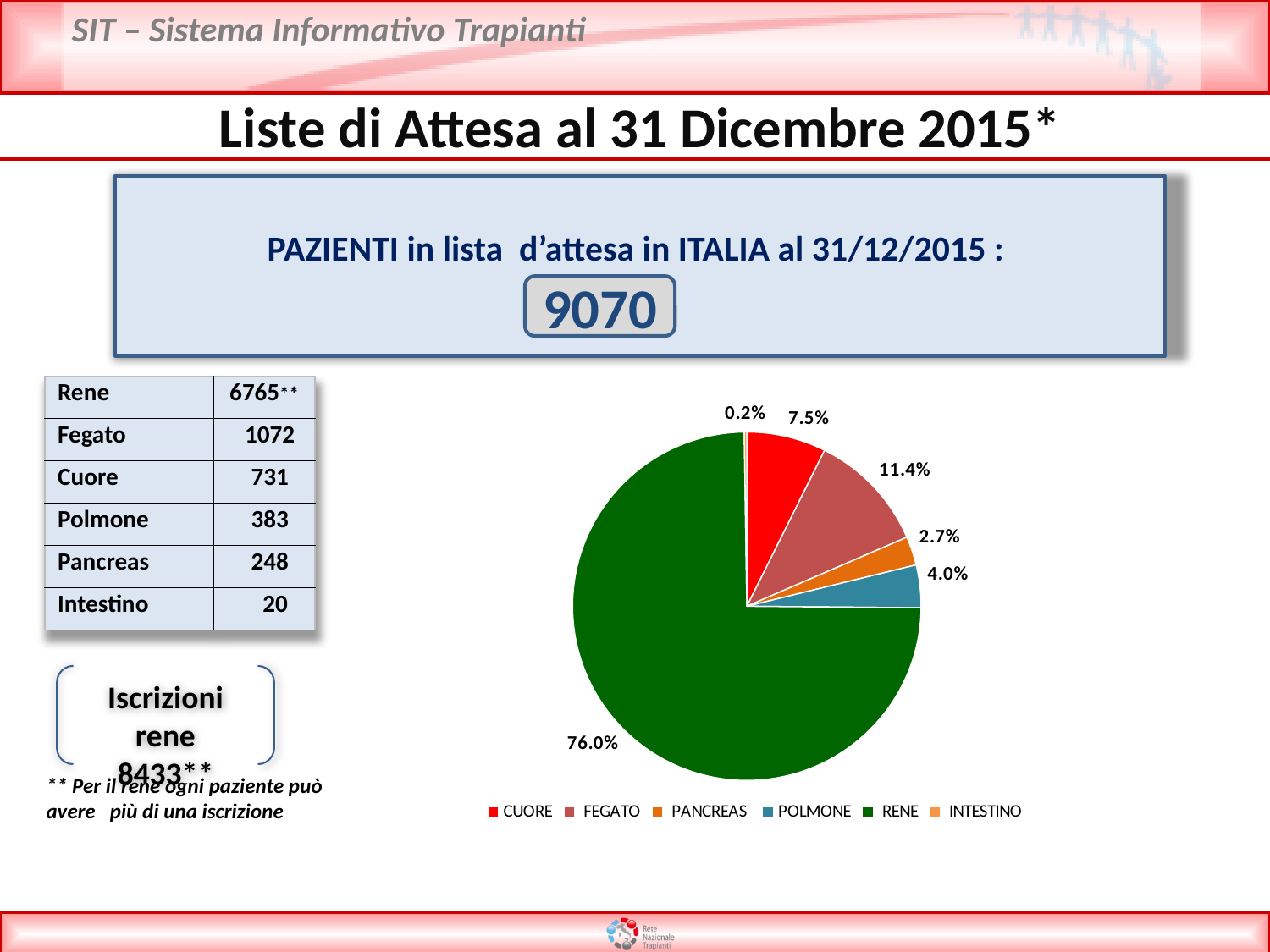
What share of the pie chart does CUORE represent? 7.5% What is the difference in percentage points between the FEGATO and CUORE slices? 3.9 What share of the pie chart does PANCREAS represent? 2.7% How many slices does the pie chart have? 6 How many entries does the pie chart's legend list? 6 Which category has the smallest slice in the pie chart? INTESTINO What share of the pie chart does POLMONE represent? 4.0% Which slice is larger in the pie chart, FEGATO or CUORE? FEGATO What kind of chart is shown on the slide? pie chart Which category has the largest slice in the pie chart? RENE